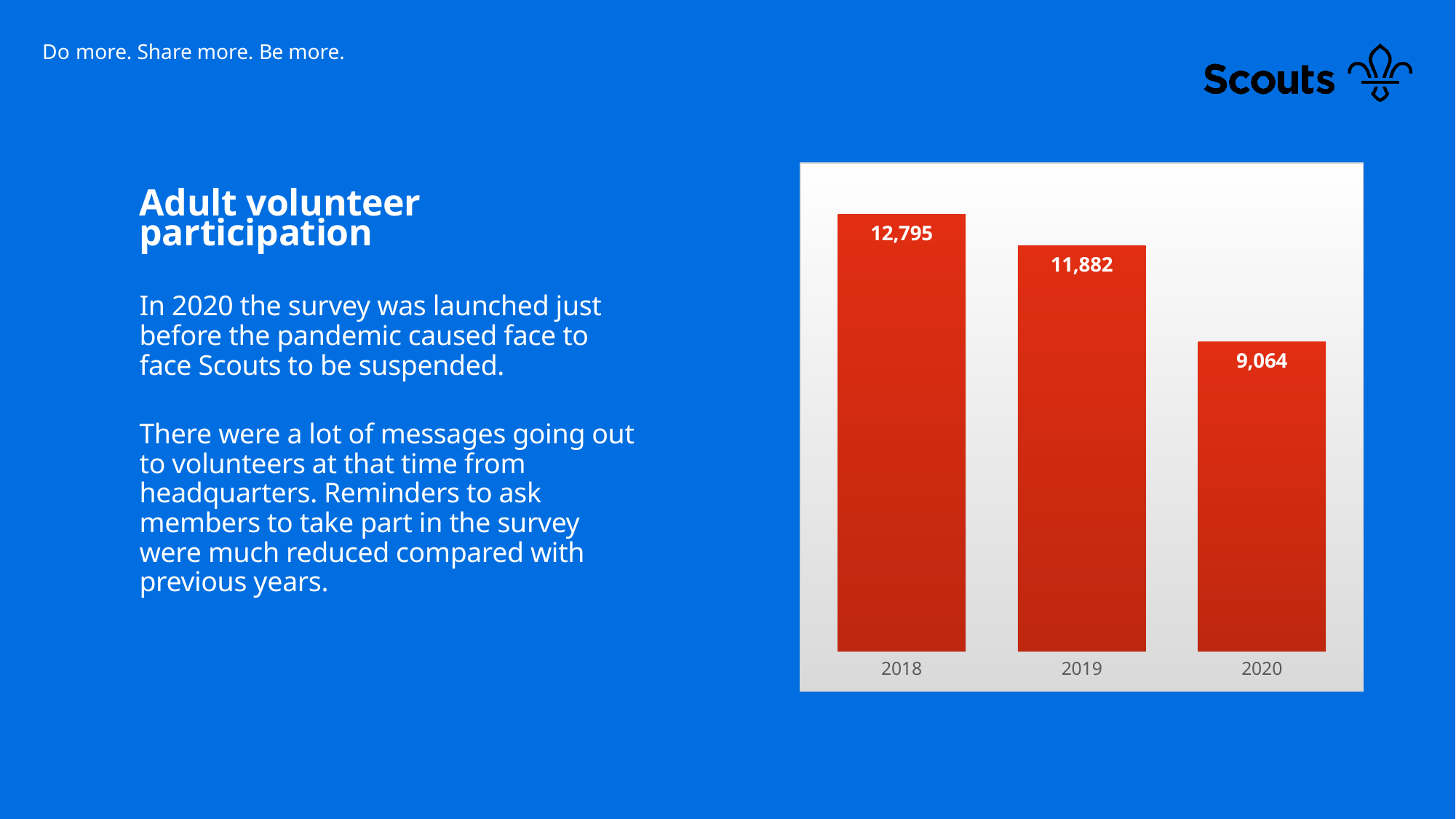
What is the value for 2019? 11,882 How many years are shown on the chart? 3 Which year has the highest value? 2018 Do the values rise or fall from 2018 to 2020? fall What is the value for 2020? 9,064 Which is larger, the value for 2019 or the value for 2020? 2019 What is the difference between the values for 2019 and 2020? 2,818 Which year has the lowest value? 2020 What is the difference between the values for 2018 and 2019? 913 What kind of chart is shown on the slide? bar chart What is the difference between the values for 2018 and 2020? 3,731 What is the value for 2018? 12,795